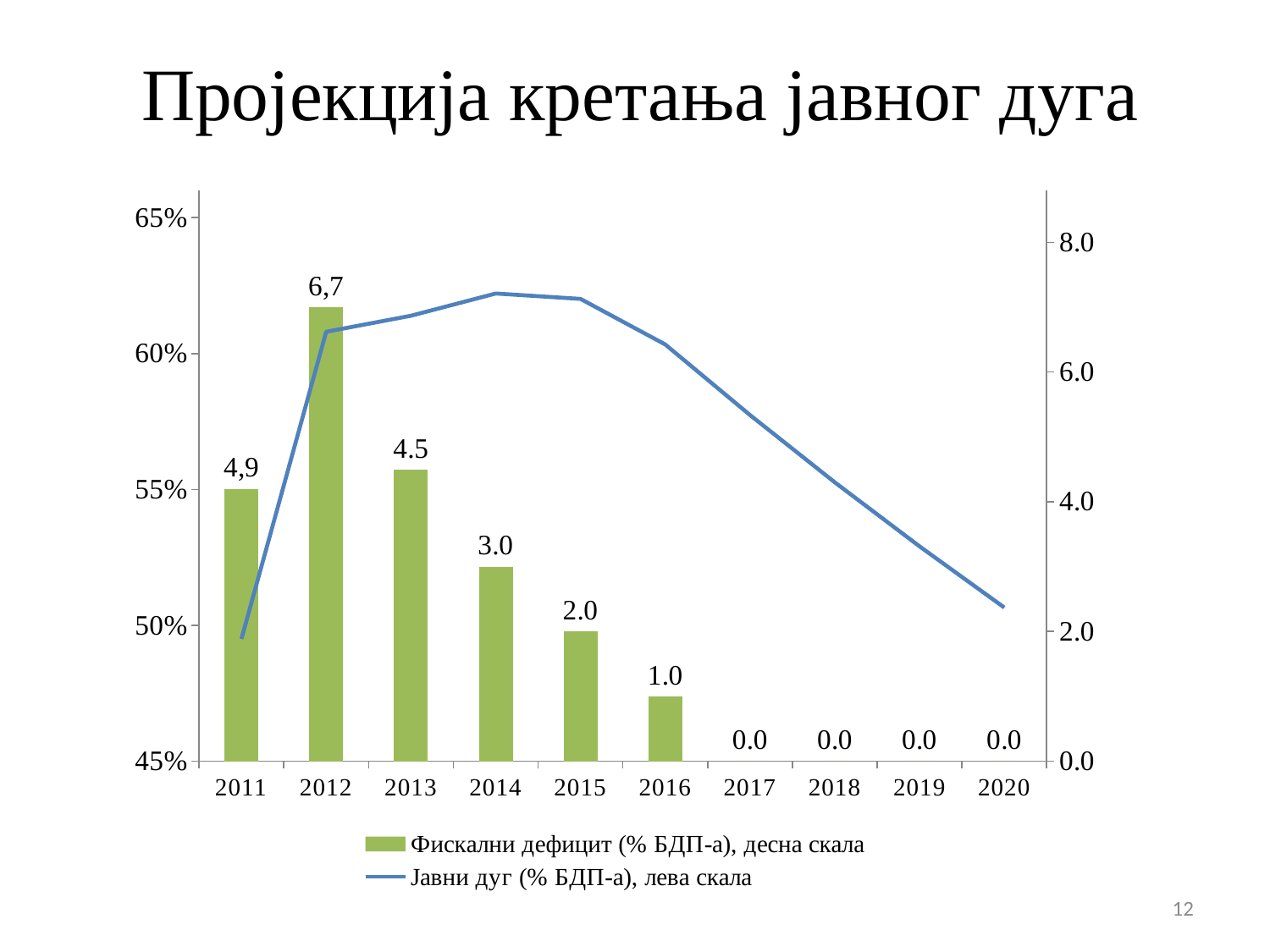
Which year has the highest fiscal deficit bar? 2012 What is the difference between the fiscal deficit values for 2013 and 2014? 1.5 What is the fiscal deficit value shown for 2014? 3.0 Is the public debt (Јавни дуг) value for 2014 greater or less than 60%? greater Is the public debt (Јавни дуг) value for 2019 greater or less than 55%? less How many years are shown on the x axis? 10 What is the fiscal deficit value shown for 2016? 1.0 Do the fiscal deficit bars rise or fall from 2012 to 2017? Fall How many series does the legend list? 2 What kind of chart is this? Combined bar and line chart What is the fiscal deficit value shown for 2012? 6,7